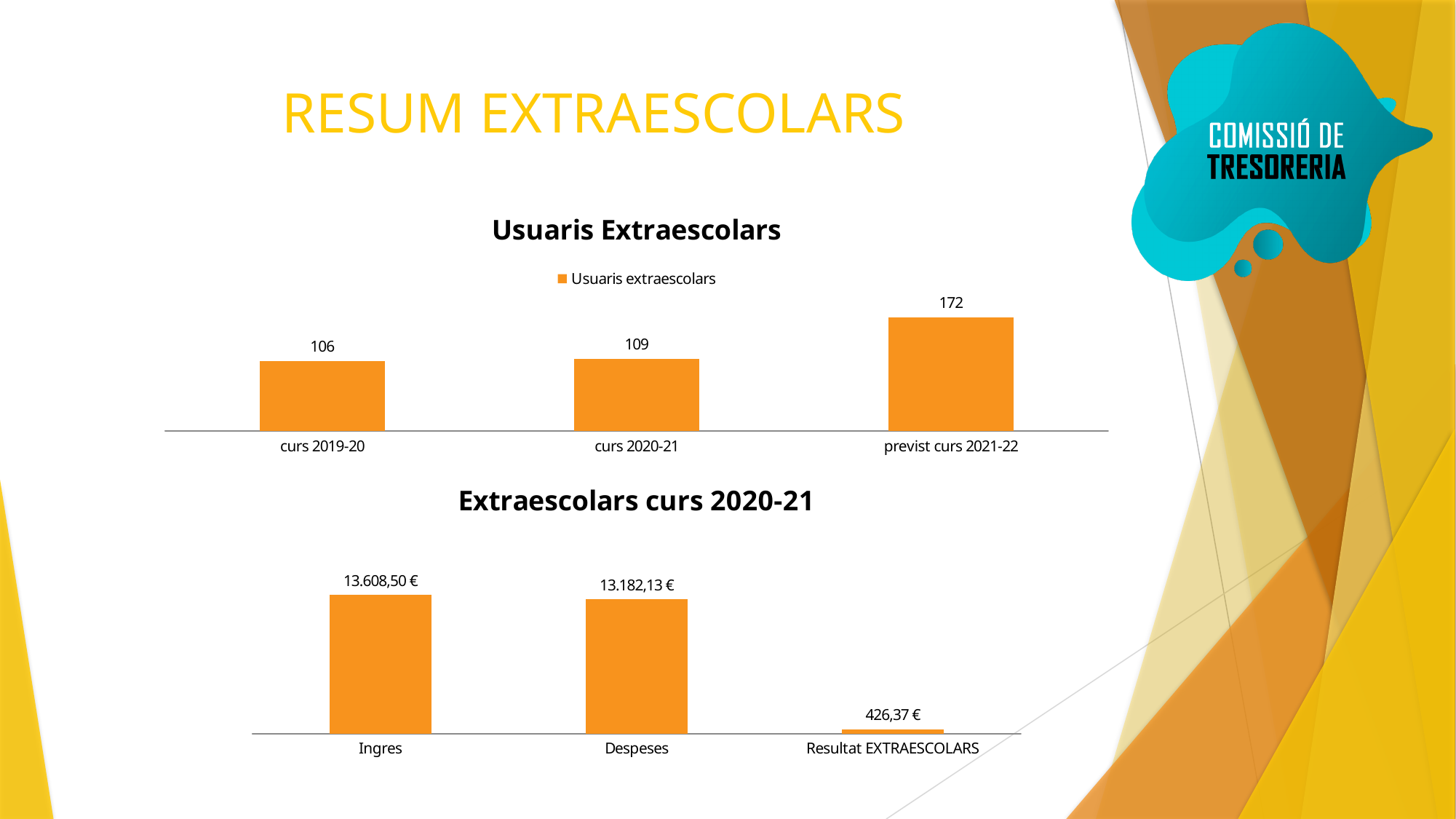
In the 'Usuaris Extraescolars' chart, what is the value for curs 2020-21? 109 In the 'Usuaris Extraescolars' chart, what is the difference between previst curs 2021-22 and curs 2019-20? 66 What kind of chart is the 'Extraescolars curs 2020-21' chart? bar chart In the 'Extraescolars curs 2020-21' chart, what is the value for Ingres? 13.608,50 € In the 'Extraescolars curs 2020-21' chart, what is the value for Resultat EXTRAESCOLARS? 426,37 € In the 'Usuaris Extraescolars' chart, how many series does the legend list? 1 In the 'Extraescolars curs 2020-21' chart, which category has the highest value? Ingres In the 'Usuaris Extraescolars' chart, do the values rise or fall from left to right along the x axis? rise In the 'Extraescolars curs 2020-21' chart, which is larger, Ingres or Despeses? Ingres In the 'Extraescolars curs 2020-21' chart, how many categories are shown? 3 In the 'Usuaris Extraescolars' chart, what is the value for previst curs 2021-22? 172 In the 'Usuaris Extraescolars' chart, which category has the lowest value? curs 2019-20